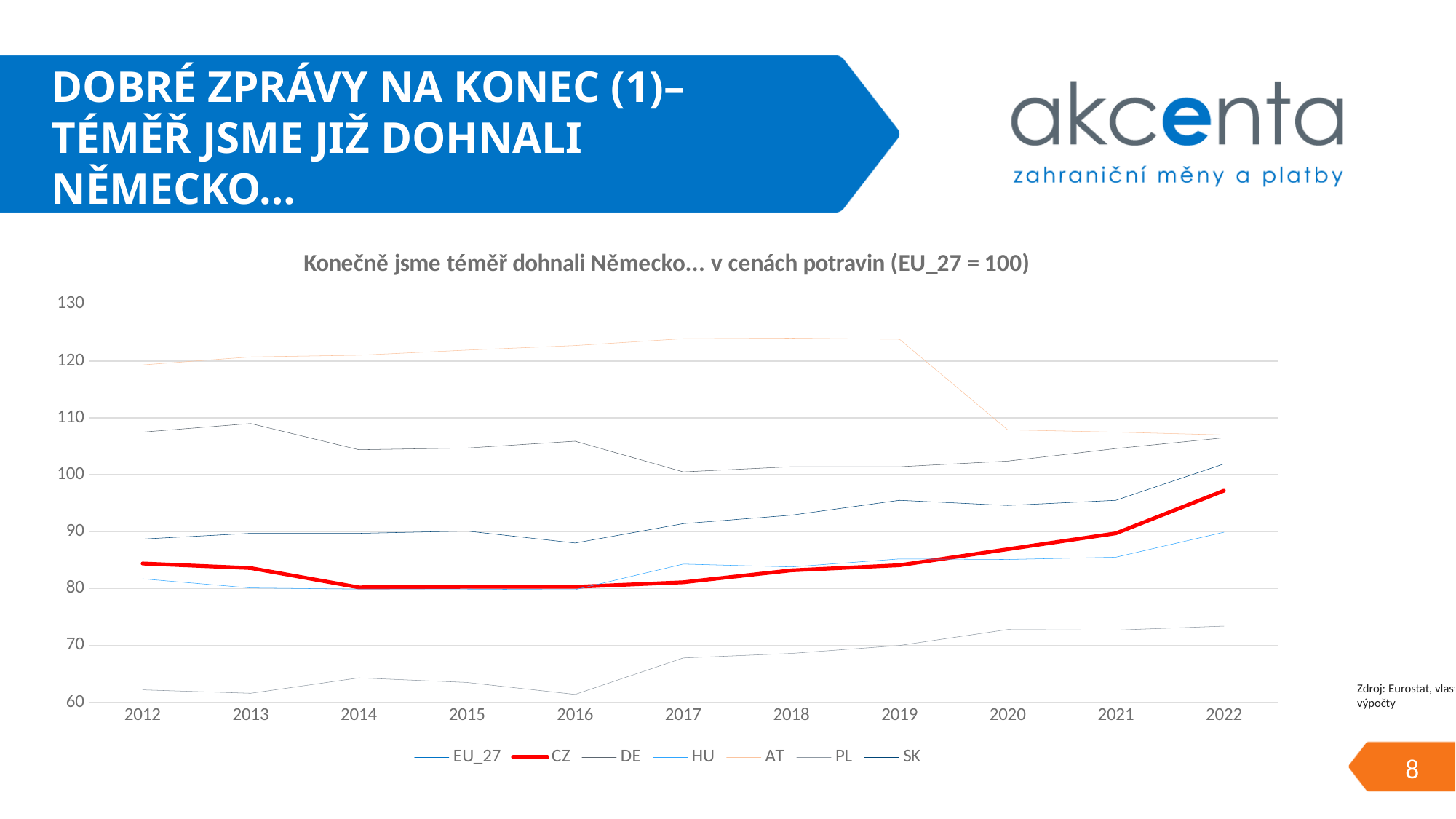
How many years are shown on the x axis? 11 Is the value for AT in 2019 greater or less than 120? greater Which series has the lowest value in 2019? PL Is the value for CZ in 2022 greater or less than 90? greater What is the value for EU_27 in 2015? 100 Is the value for CZ in 2014 greater or less than 90? less What kind of chart is shown on the slide? line chart Which series has the highest value in 2019? AT Which is higher in 2022, CZ or HU? CZ Does the CZ line rise or fall overall from 2012 to 2022? rise How many series does the legend list? 7